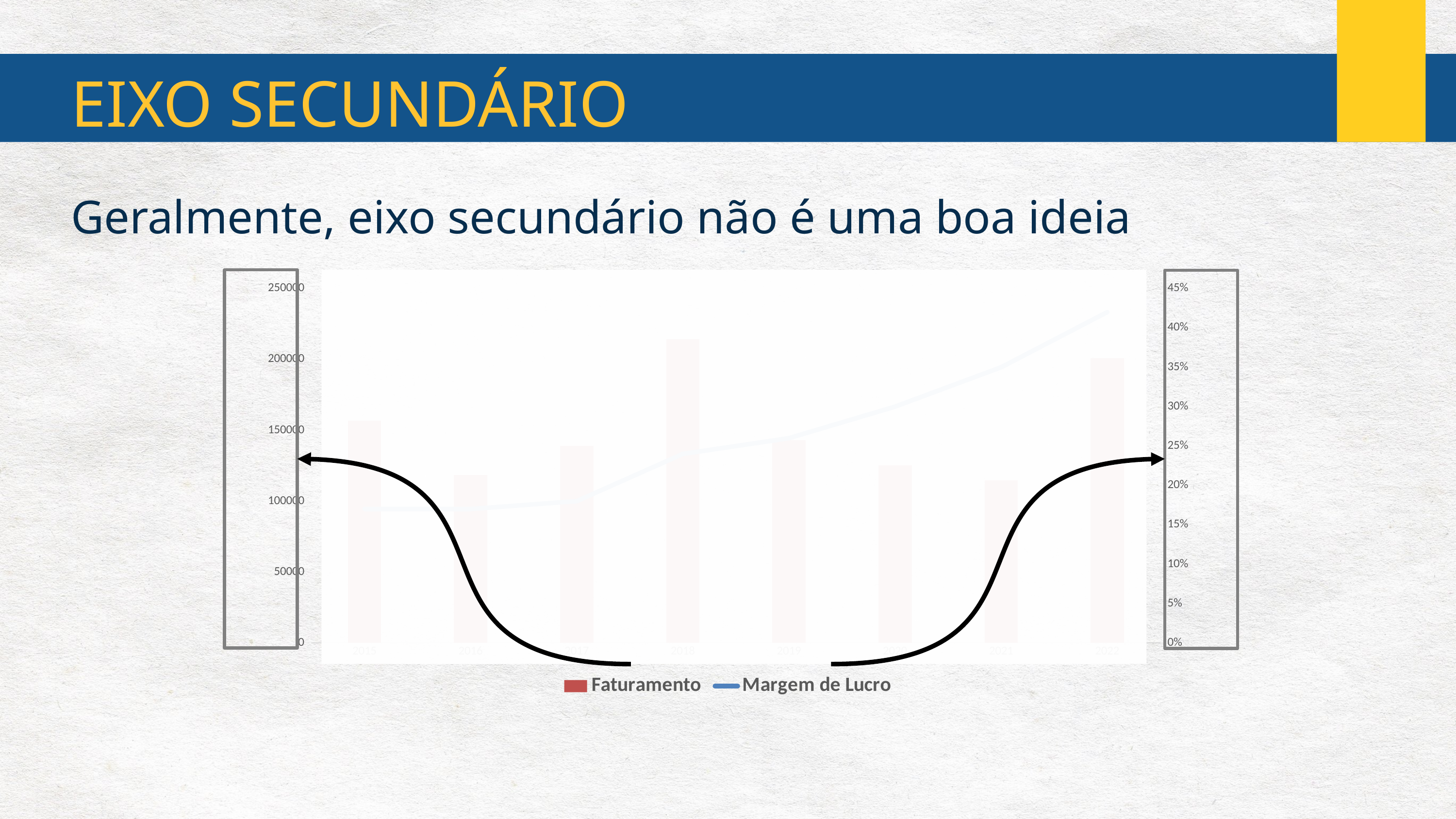
Does the Margem de Lucro line rise or fall from 2015 to 2022? rises Is the Margem de Lucro value for 2015 greater or less than 20%? less Which year has the highest Faturamento bar? 2018 What kind of chart is shown on the slide? A combined bar and line chart How many years are shown along the x axis? 8 What is the highest tick value on the left (primary) axis? 250000 How many series does the legend list? 2 What is the highest tick value on the right (secondary) axis? 45% Is the Faturamento value for 2016 greater or less than 150000? less Which series is plotted as bars? Faturamento Is the Faturamento value for 2018 greater or less than 200000? greater What are the two series named in the legend? Faturamento and Margem de Lucro